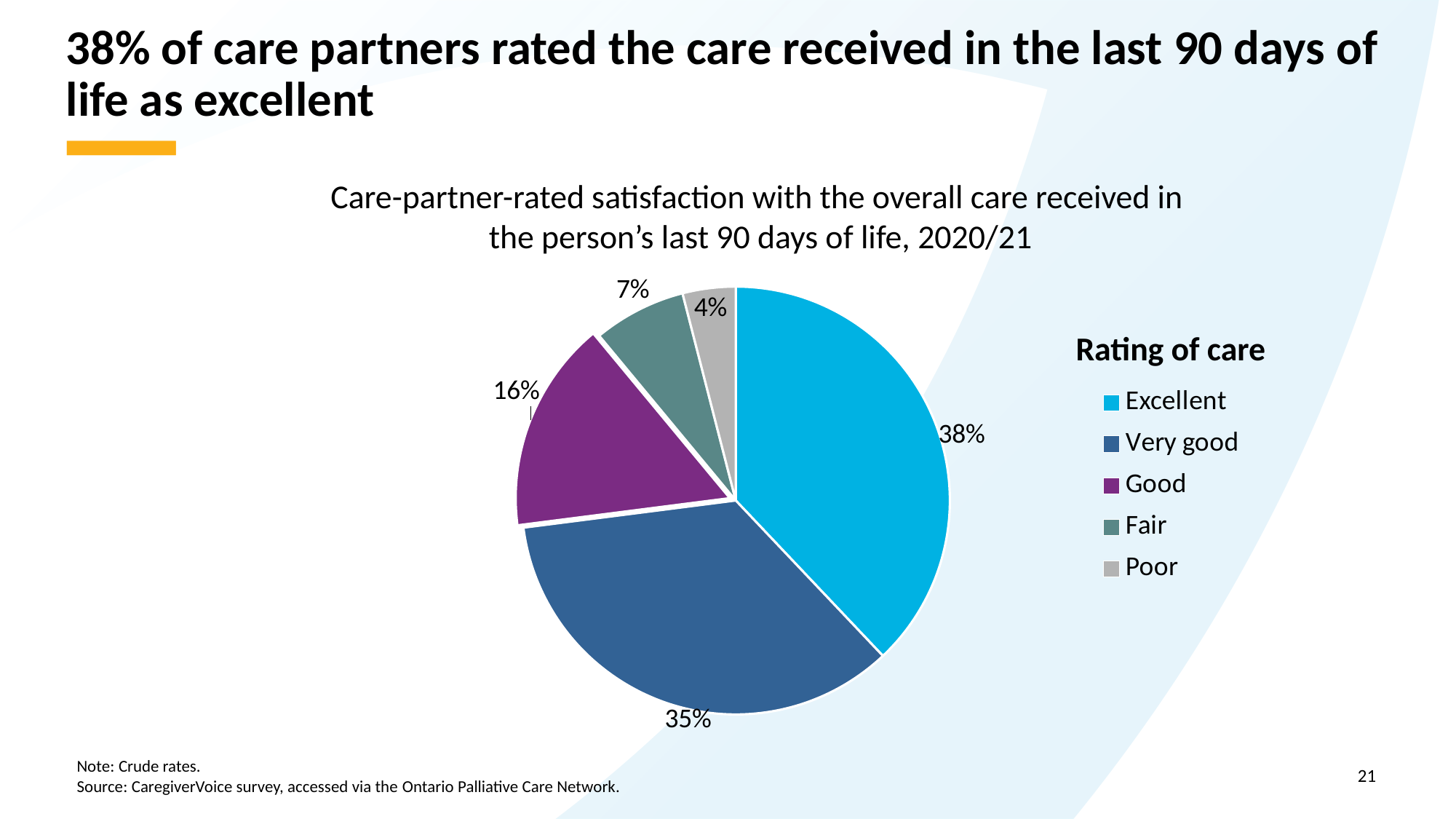
Which rating of care has the largest share of the pie? Excellent Which rating of care has the smallest share of the pie? Poor What percentage of care partners rated the care as Fair? 7% What percentage of care partners rated the care as Very good? 35% What percentage of care partners rated the care as Poor? 4% What percentage of care partners rated the care as Good? 16% What percentage of care partners rated the care as Excellent? 38% What is the difference in percentage points between the Excellent and Very good slices? 3 What kind of chart is shown on the slide? Pie chart Which slice is larger, Good or Fair? Good What is the title of the legend? Rating of care How many rating categories are shown in the pie chart? 5